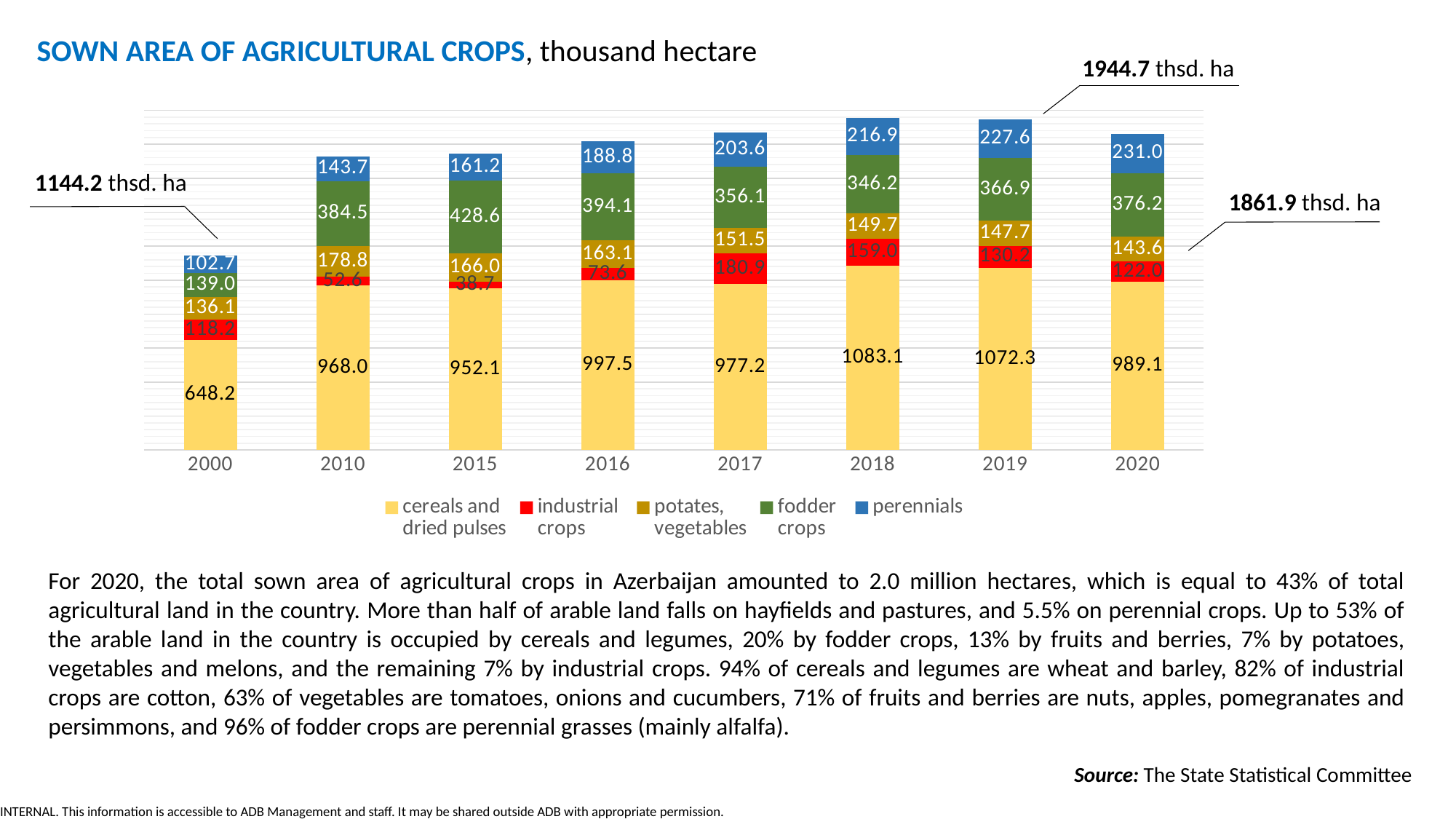
Which year has the lowest value for industrial crops? 2015 How many series does the legend list? 5 What is the value for cereals and dried pulses in 2018? 1083.1 What is the total sown area for 2020 according to the chart annotation? 1861.9 thsd. ha What kind of chart is shown on the slide? Stacked bar chart What is the value for perennials in 2020? 231.0 Which is larger, the perennials value for 2019 or for 2020? 2020 What is the difference between the fodder crops values for 2015 and 2010? 44.1 How many years are shown on the x axis? 8 Do the perennials values rise or fall from 2000 to 2020? Rise What is the value for industrial crops in 2017? 180.9 Which year has the highest value for cereals and dried pulses? 2018